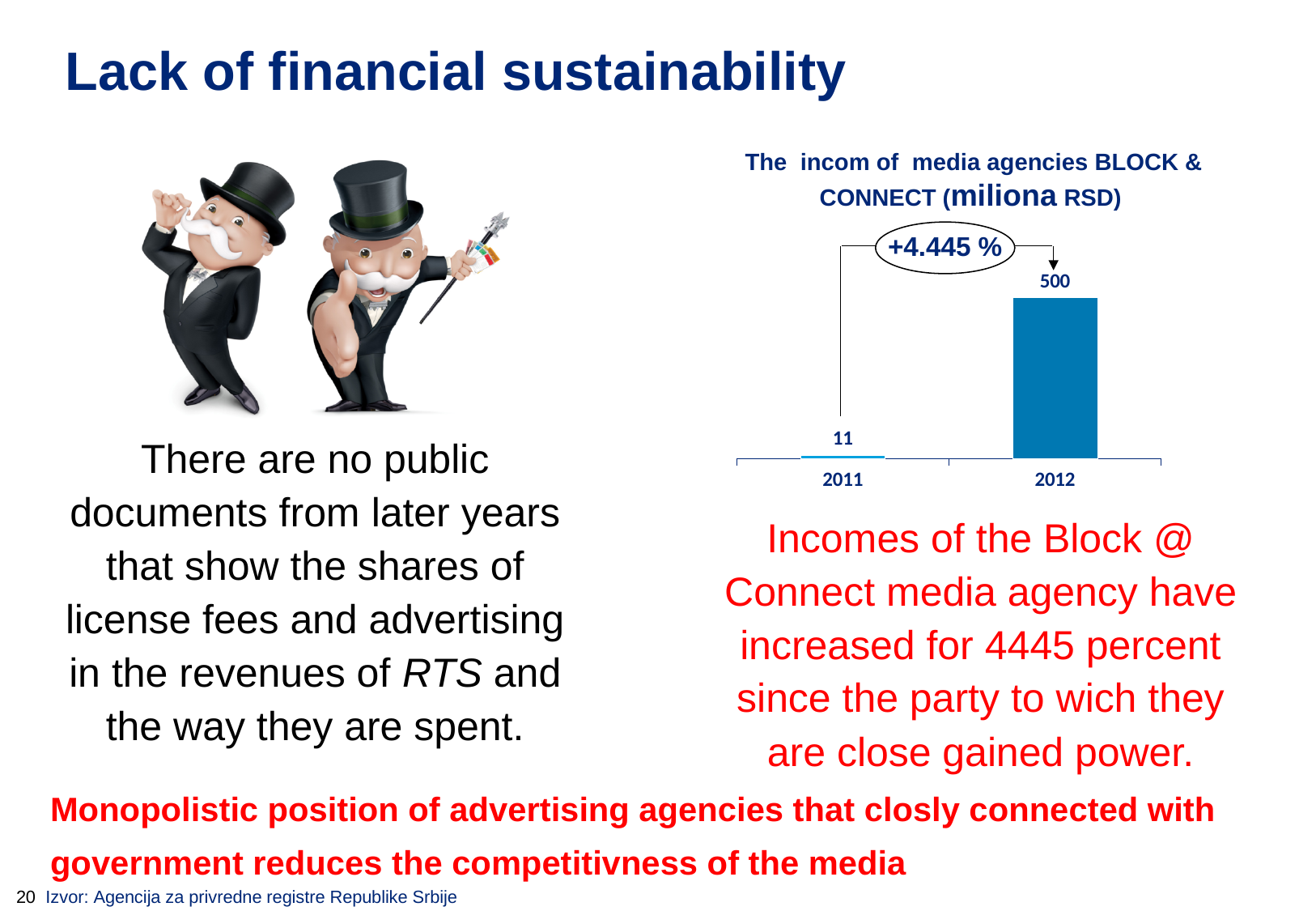
What is the difference between the 2012 and 2011 income values? 489 How many years are shown on the x axis of the chart? 2 What is the income value shown for 2011? 11 Is the value for 2012 larger than the value for 2011? Yes What kind of chart is shown on the slide? Bar chart Do the values rise or fall from 2011 to 2012? Rise Which year has the higher income value? 2012 What unit is given in the chart title for the income values? miliona RSD What percentage change is annotated on the chart between 2011 and 2012? +4.445 % Which year has the lower income value? 2011 What is the income value shown for 2012? 500